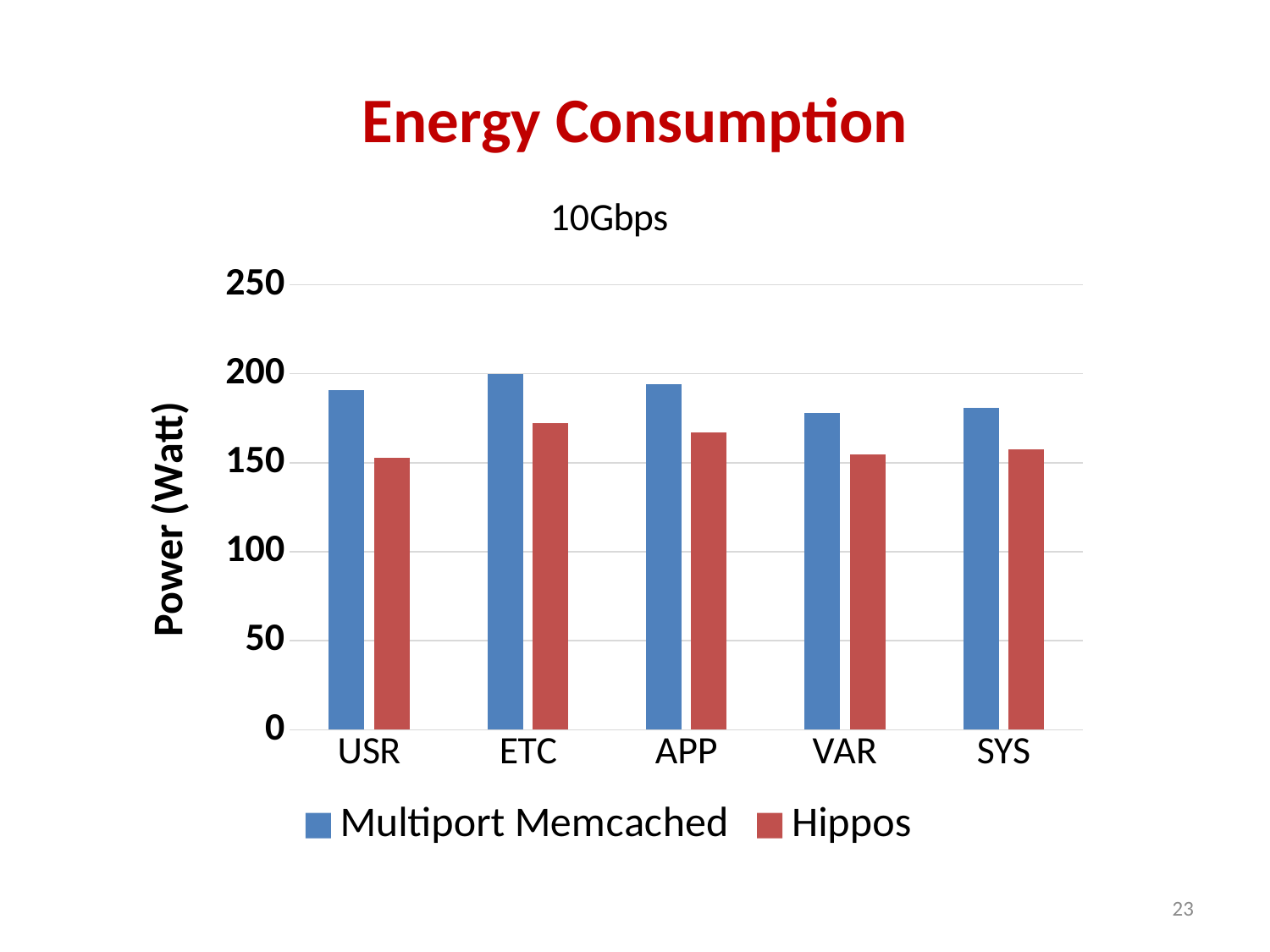
What is the label of the y axis? Power (Watt) What kind of chart is shown on the slide? bar chart How many series does the legend list? 2 For USR, which series has the larger value, Multiport Memcached or Hippos? Multiport Memcached How many categories are shown on the x axis of the chart? 5 Is the Multiport Memcached value for USR greater or less than 150? greater Is the Hippos value for ETC greater or less than 150? greater For SYS, which series has the larger value, Multiport Memcached or Hippos? Multiport Memcached Is the Hippos value for APP greater or less than 200? less What is the title of the chart? 10Gbps Which category has the highest Multiport Memcached value? ETC